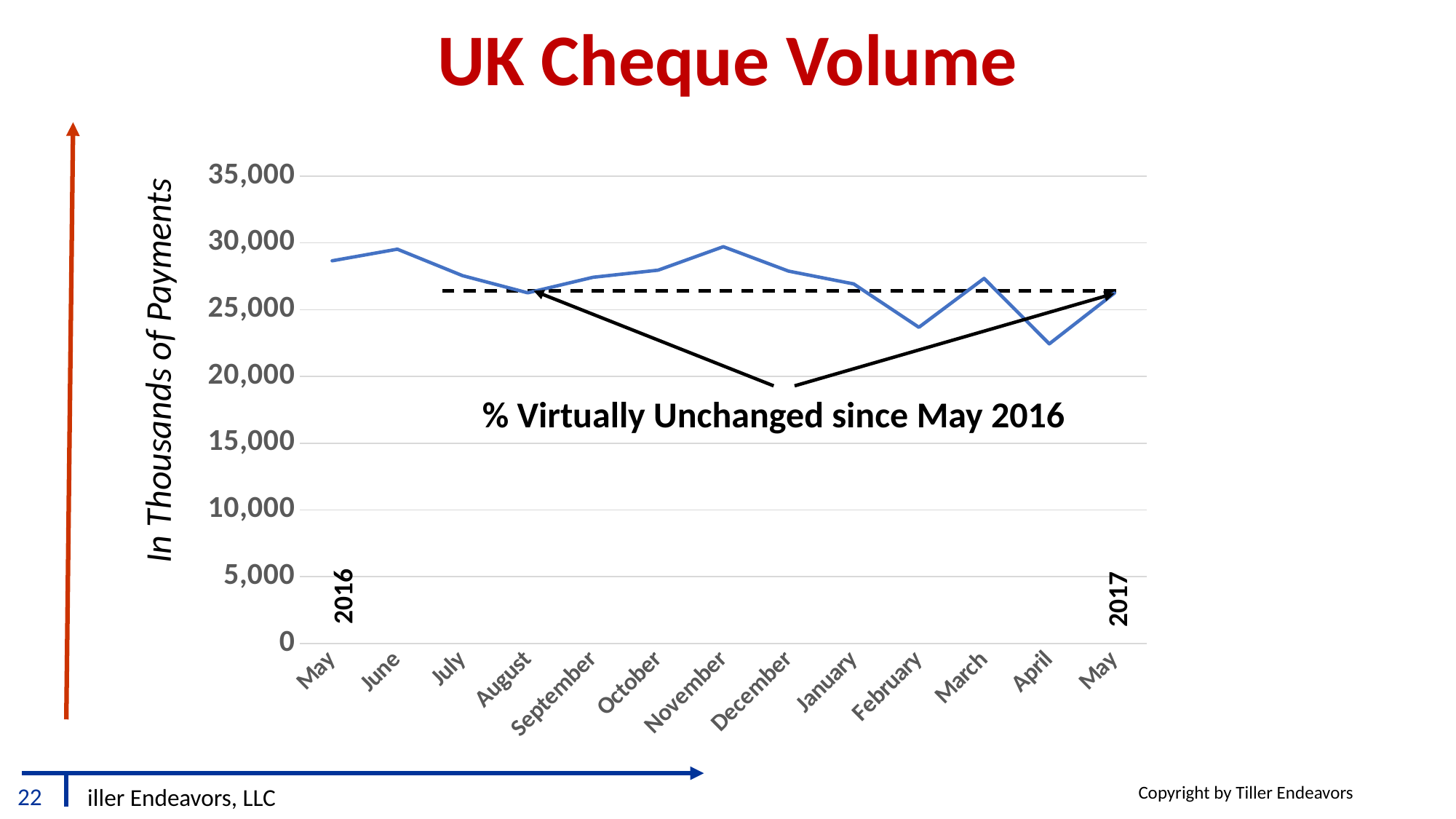
Is the value for June greater or less than 25,000? greater Which is larger, the value for November or the value for February? November What is the title of the chart? UK Cheque Volume What is the label on the vertical axis of the chart? In Thousands of Payments Which month has the lowest cheque volume on the chart? April Is the value for May 2016 greater or less than 30,000? less Which is larger, the value for June or the value for April? June Which is larger, the value for February or the value for March? March How many monthly data points are plotted on the line? 13 What kind of chart is shown on the slide? line chart Is the value for February greater or less than 25,000? less